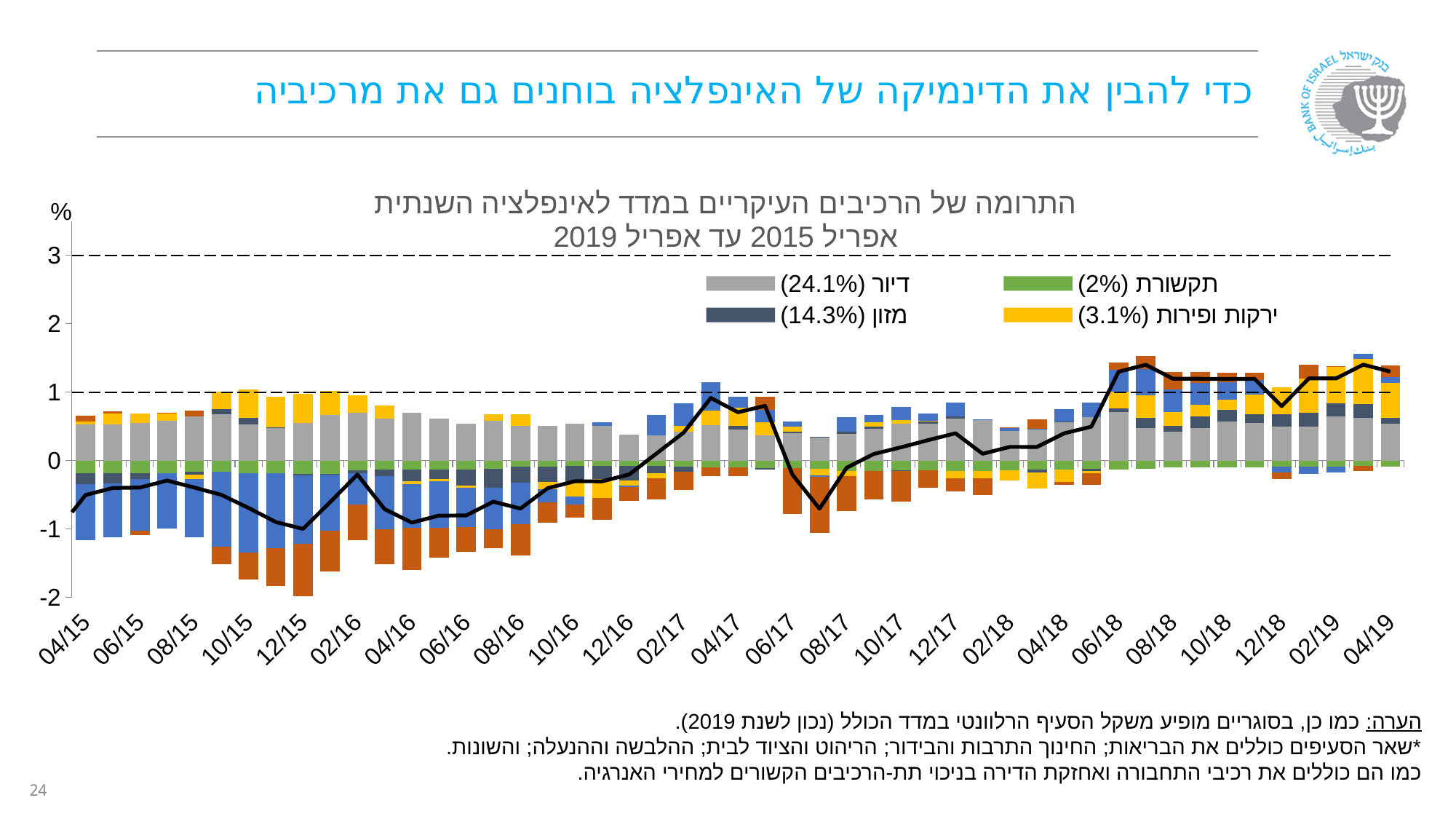
Is the value of the black line at 04/19 greater or less than 1? greater Does the black line overall rise or fall from 04/15 to 04/19? rise How many series does the legend list? 4 What percentage weight is shown in the legend next to ירקות ופירות? 3.1% What kind of chart is shown on the slide? combination bar and line chart What percentage weight is shown in the legend next to דיור? 24.1% What is the highest value shown on the vertical axis? 3 Is the black line higher at 04/19 or at 04/15? 04/19 Is the value of the black line at 12/15 greater or less than 0? less Is the value of the black line at 08/18 greater or less than 1? greater